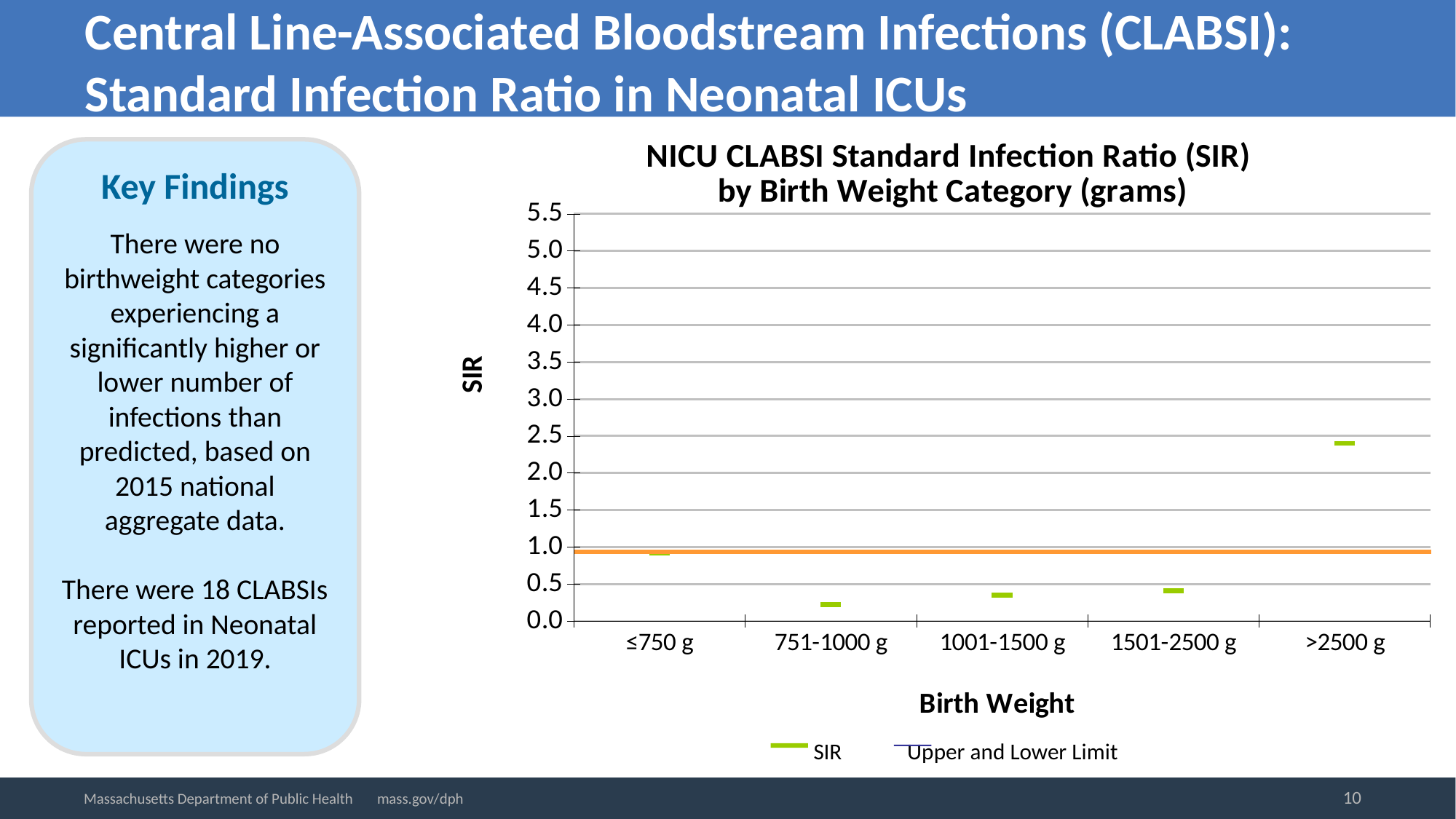
What is the title of the x axis in the NICU CLABSI SIR chart? Birth Weight How many series does the legend of the NICU CLABSI SIR chart list? 2 Is the SIR for the >2500 g category greater or less than 2.5? less Is the SIR for the ≤750 g category greater or less than 1.0? less Which birth weight category has the lowest SIR in the NICU CLABSI SIR chart? 751-1000 g Which has a higher SIR: the ≤750 g category or the >2500 g category? >2500 g How many birth weight categories are shown on the x axis of the NICU CLABSI SIR chart? 5 Is the SIR for the 1501-2500 g category greater or less than 0.5? less Which birth weight category has the highest SIR in the NICU CLABSI SIR chart? >2500 g Which has a higher SIR: the 751-1000 g category or the 1501-2500 g category? 1501-2500 g